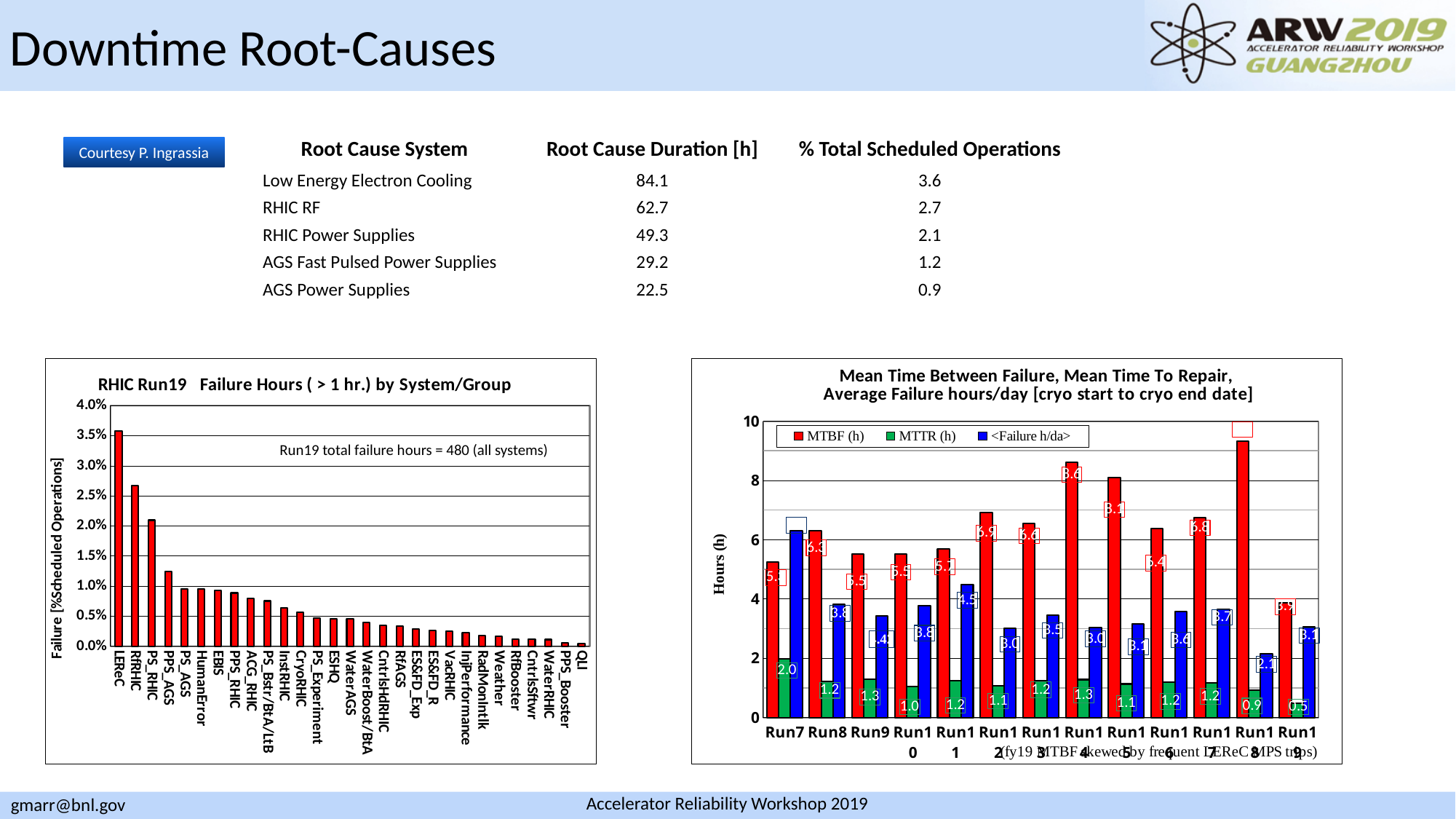
In the left chart 'RHIC Run19 Failure Hours', what is the Run19 total failure hours stated in the annotation? 480 How many series does the legend of the right chart 'Mean Time Between Failure, Mean Time To Repair, Average Failure hours/day' list? 3 In the right chart 'Mean Time Between Failure, Mean Time To Repair, Average Failure hours/day', what is the difference between the MTTR (h) for Run7 and Run19? 1.5 In the right chart 'Mean Time Between Failure, Mean Time To Repair, Average Failure hours/day', what is the MTBF (h) value for Run14? 8.6 What kind of chart is the left chart, 'RHIC Run19 Failure Hours (> 1 hr.) by System/Group'? bar chart In the left chart 'RHIC Run19 Failure Hours', is the value for PPS_AGS greater or less than 1.5%? less In the right chart 'Mean Time Between Failure, Mean Time To Repair, Average Failure hours/day', which run has the lowest MTTR (h)? Run19 In the right chart 'Mean Time Between Failure, Mean Time To Repair, Average Failure hours/day', what is the <Failure h/da> value for Run11? 4.5 In the left chart 'RHIC Run19 Failure Hours', which system/group has the highest failure percentage? LEReC In the right chart 'Mean Time Between Failure, Mean Time To Repair, Average Failure hours/day', what is the MTTR (h) value for Run7? 2.0 In the right chart 'Mean Time Between Failure, Mean Time To Repair, Average Failure hours/day', which is larger, the MTBF (h) for Run14 or for Run15? Run14 In the left chart 'RHIC Run19 Failure Hours', is the value for LEReC greater or less than 3.0%? greater